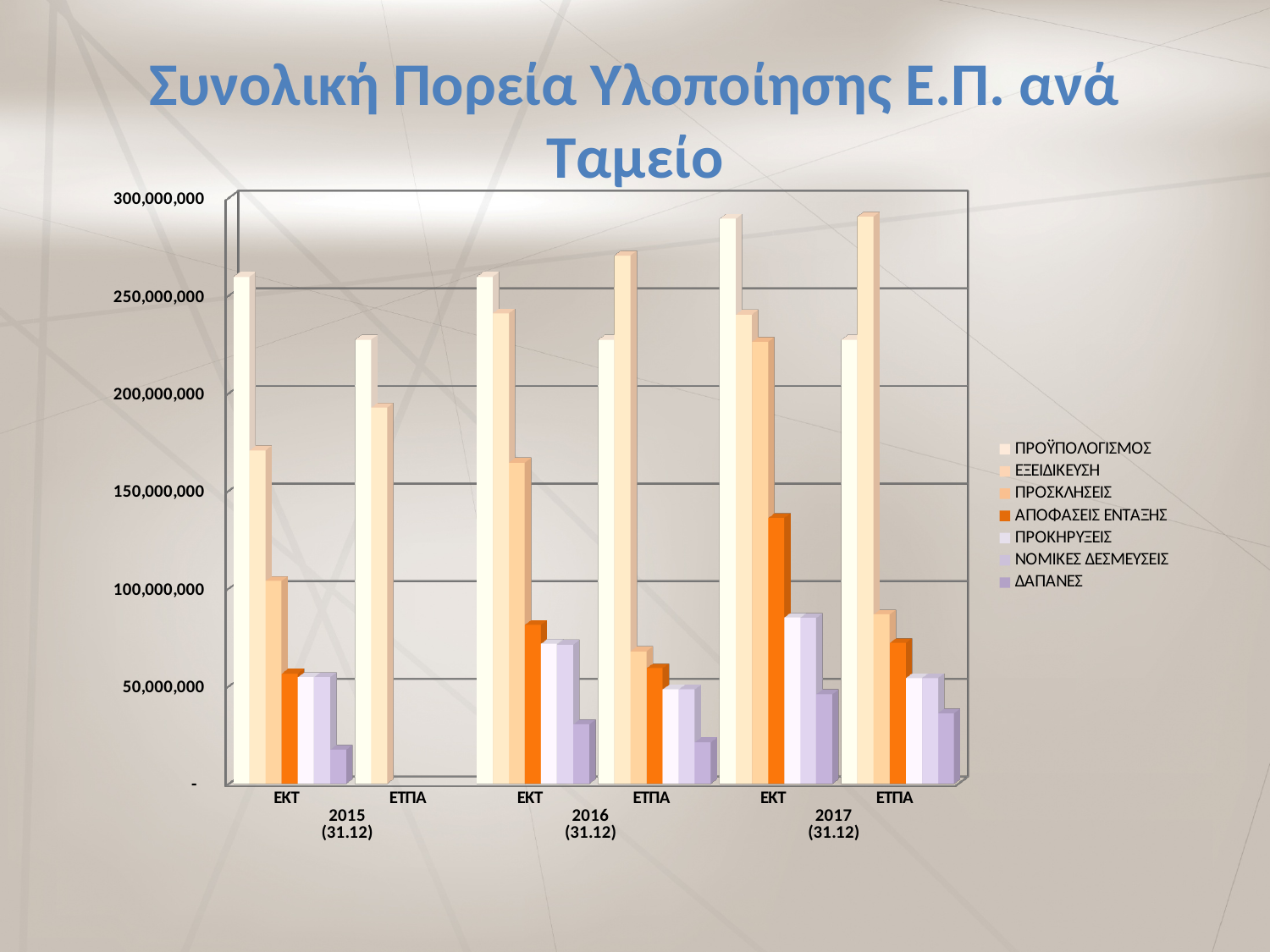
Does the ΑΠΟΦΑΣΕΙΣ ΕΝΤΑΞΗΣ value for ΕΚΤ rise or fall from 2015 to 2017? rise Which is larger in 2017 (31.12), the ΑΠΟΦΑΣΕΙΣ ΕΝΤΑΞΗΣ value for ΕΚΤ or for ΕΤΠΑ? ΕΚΤ Is the ΠΡΟΫΠΟΛΟΓΙΣΜΟΣ value for ΕΤΠΑ in 2015 (31.12) greater or less than 250,000,000? less Is the ΔΑΠΑΝΕΣ value for ΕΚΤ in 2015 (31.12) greater or less than 50,000,000? less Is the ΑΠΟΦΑΣΕΙΣ ΕΝΤΑΞΗΣ value for ΕΚΤ in 2017 (31.12) greater or less than 100,000,000? greater How many series does the legend list? 7 What kind of chart is shown on the slide? Bar chart Which series is shown in dark orange in the legend? ΑΠΟΦΑΣΕΙΣ ΕΝΤΑΞΗΣ What is the title of the chart? Συνολική Πορεία Υλοποίησης Ε.Π. ανά Ταμείο Which category group has the highest ΑΠΟΦΑΣΕΙΣ ΕΝΤΑΞΗΣ value? ΕΚΤ 2017 (31.12) How many category groups (fund/year combinations) are shown along the x axis? 6